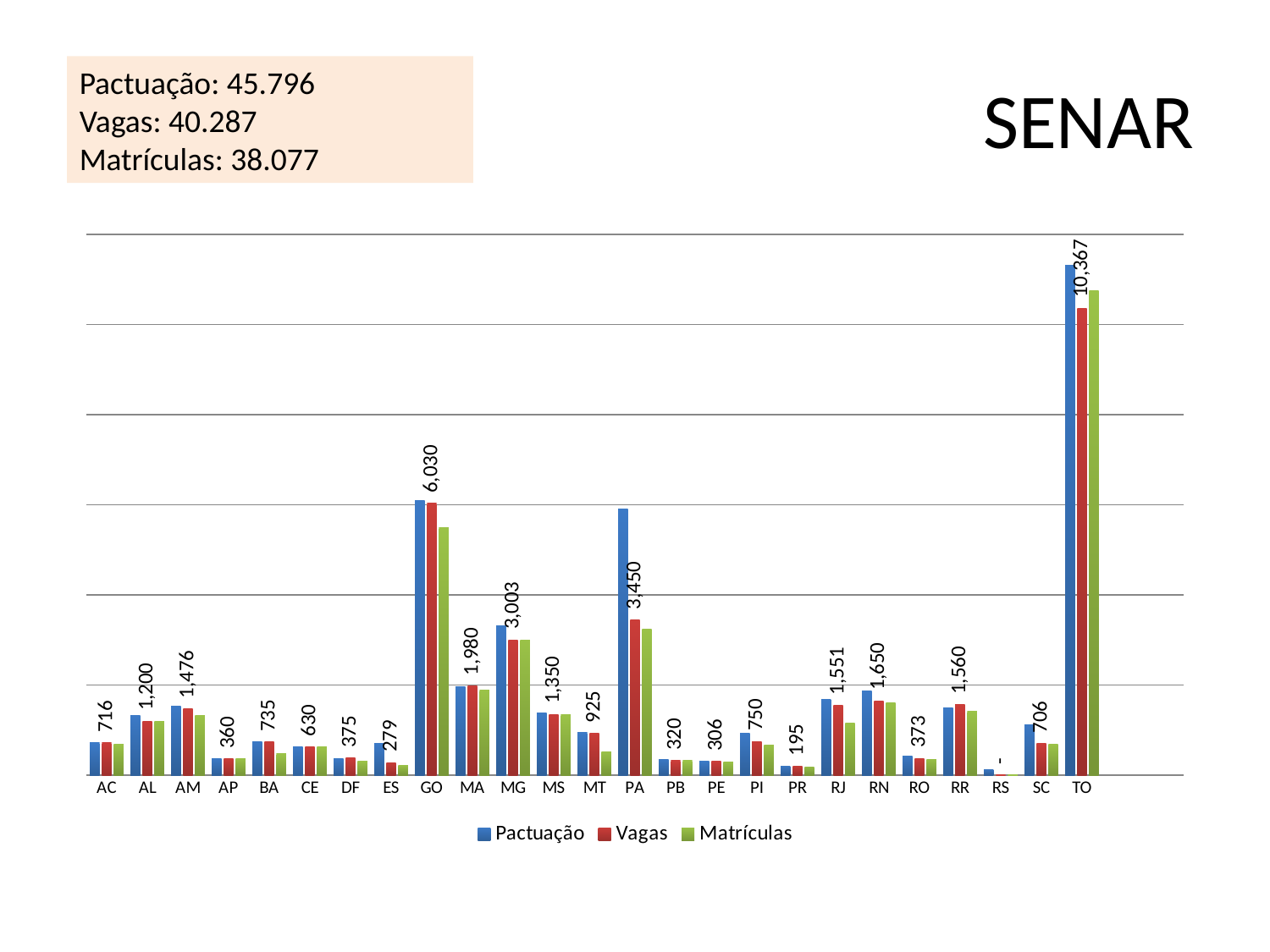
What are the three series named in the legend? Pactuação, Vagas, Matrículas How many series does the legend list? 3 Which state has the highest Pactuação value? TO For TO, which is larger, Pactuação or Vagas? Pactuação Which has the larger Pactuação value, AM or AL? AM What kind of chart is shown on the slide? bar chart How many states (categories) are shown on the x axis? 25